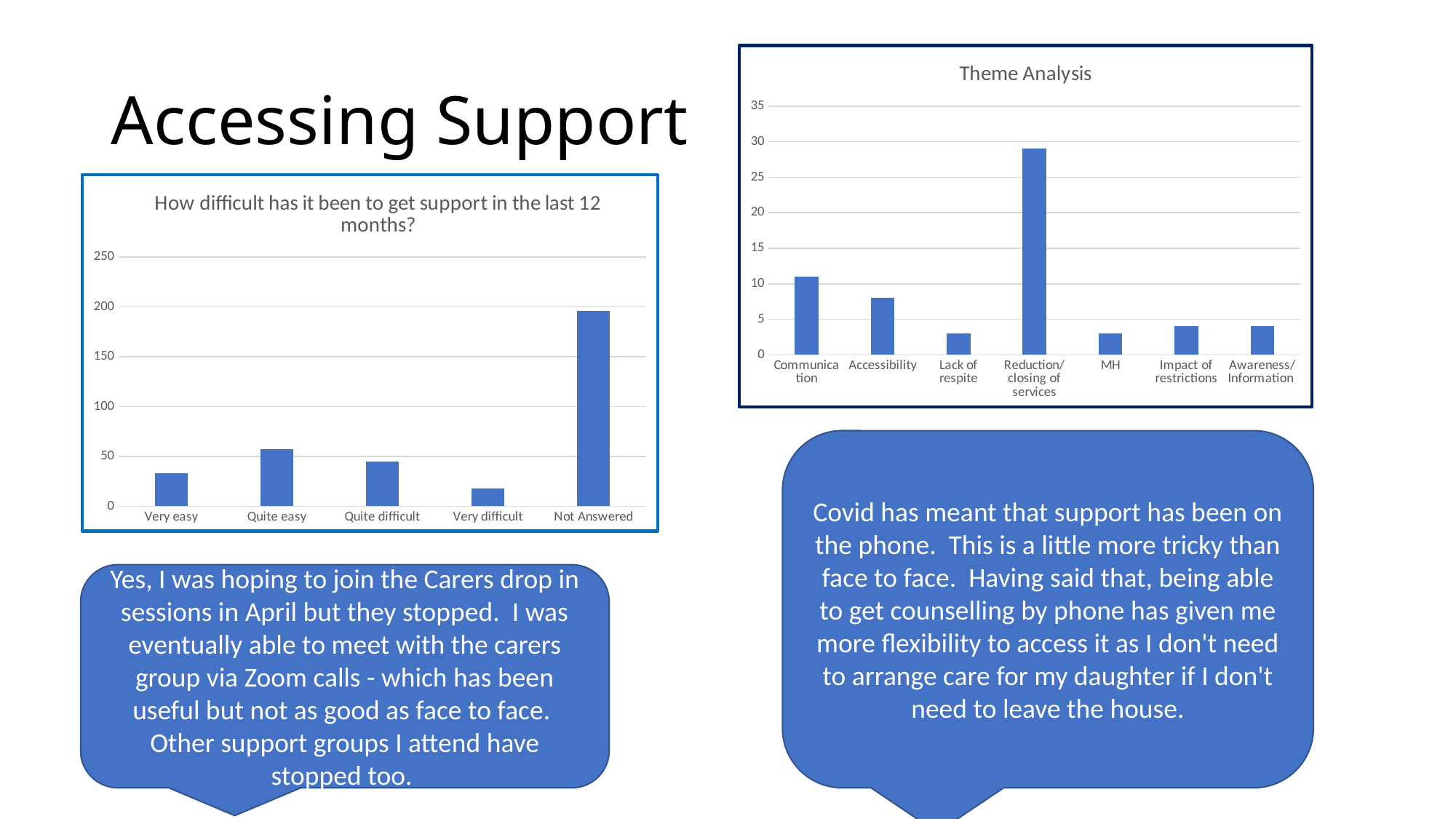
How many themes are shown on the 'Theme Analysis' chart? 7 On the 'Theme Analysis' chart, which theme has the highest value? Reduction/closing of services On the 'Theme Analysis' chart, is the value for Accessibility greater or less than 10? less On the 'How difficult has it been to get support in the last 12 months?' chart, is the value for Very easy greater or less than 50? less On the 'How difficult has it been to get support in the last 12 months?' chart, is the value for Not Answered greater or less than 150? greater On the 'Theme Analysis' chart, which is larger, Communication or Accessibility? Communication How many categories are shown on the 'How difficult has it been to get support in the last 12 months?' chart? 5 On the 'How difficult has it been to get support in the last 12 months?' chart, which category has the lowest value? Very difficult On the 'How difficult has it been to get support in the last 12 months?' chart, which is larger, Quite easy or Quite difficult? Quite easy On the 'How difficult has it been to get support in the last 12 months?' chart, which category has the highest value? Not Answered What kind of chart is the 'Theme Analysis' chart? bar chart